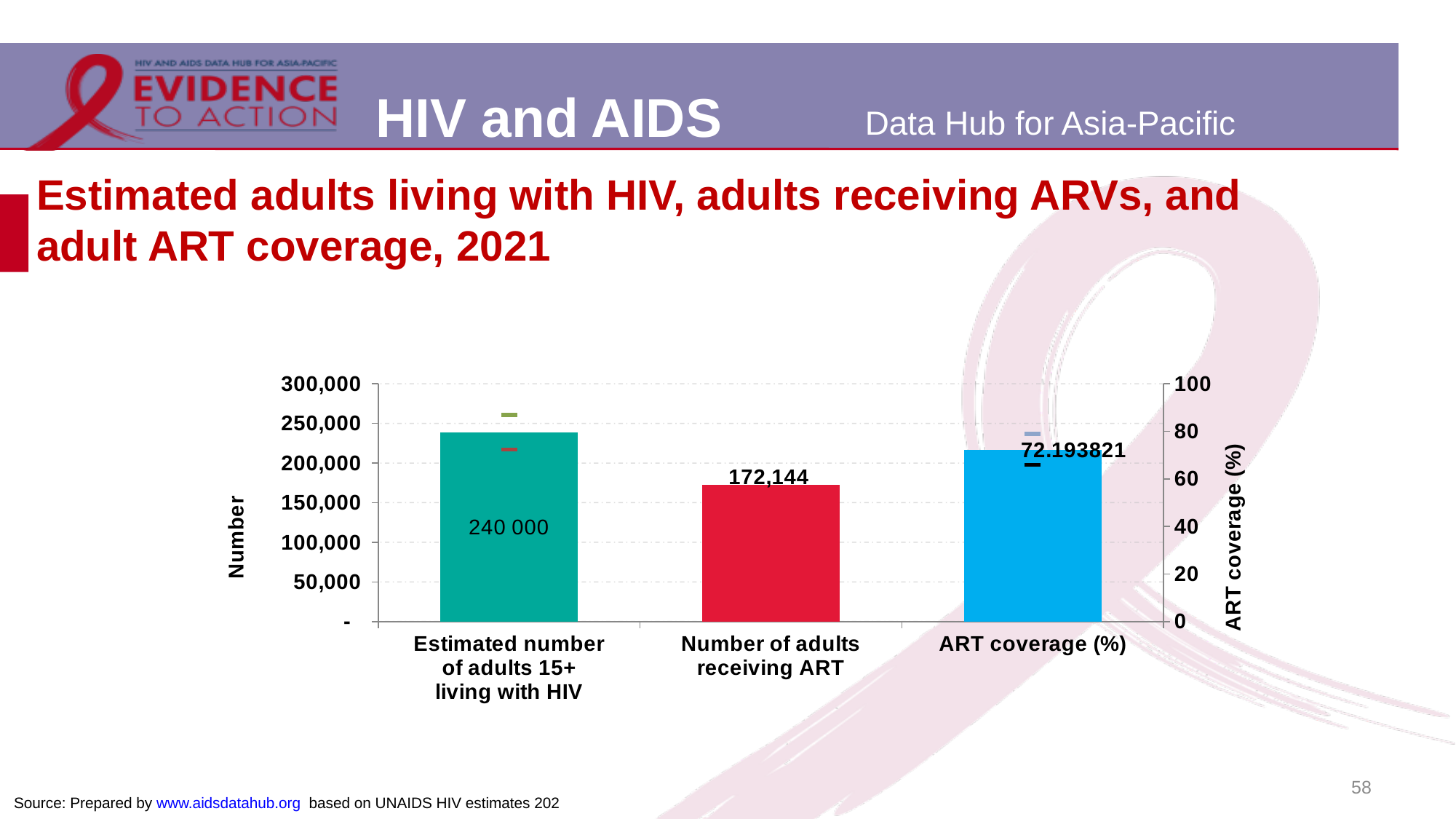
What is the ART coverage (%) value shown on the chart? 72.193821 Is the ART coverage (%) bar greater or less than 60 on the right-hand axis? greater What is the number of adults receiving ART shown on the chart? 172,144 What kind of chart is shown on the slide? Bar chart What is the estimated number of adults 15+ living with HIV shown on the chart? 240 000 What is the label of the right vertical axis of the chart? ART coverage (%) What is the difference between the estimated number of adults 15+ living with HIV and the number of adults receiving ART? 67,856 How many bars are plotted on the chart? 3 Is the bar for the number of adults receiving ART greater or less than 200,000? less What is the label of the left vertical axis of the chart? Number Is the bar for the estimated number of adults 15+ living with HIV greater or less than 200,000? greater Which is larger: the estimated number of adults 15+ living with HIV or the number of adults receiving ART? Estimated number of adults 15+ living with HIV